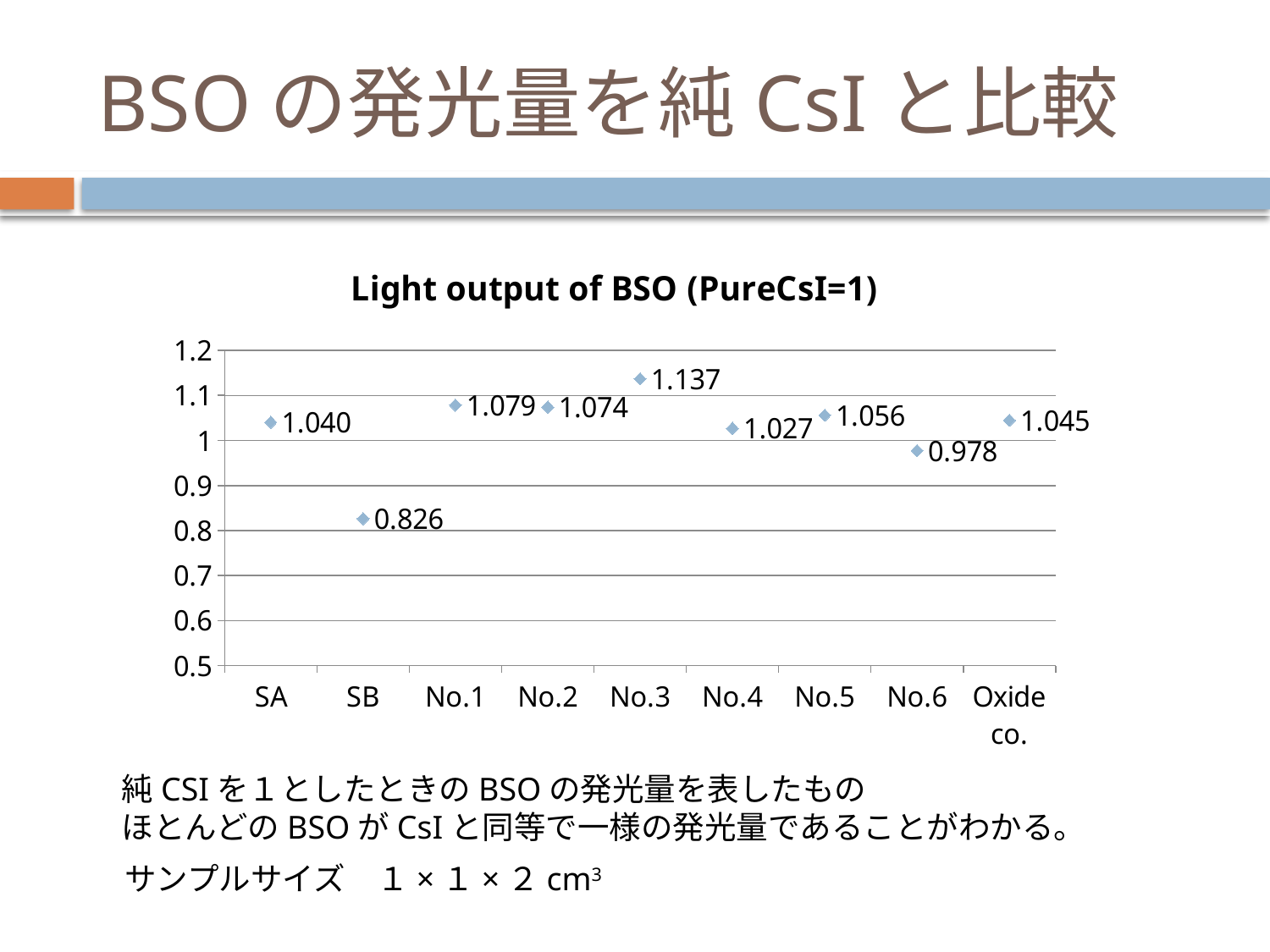
What kind of chart is shown on the slide? scatter chart Is the value for No.6 greater or less than 1? less Which sample has the highest light output? No.3 Which sample has the lowest light output? SB What is the light output value for sample SB? 0.826 Which has a larger light output, SA or No.4? SA How many samples are plotted on the chart? 9 What is the light output value for Oxide co.? 1.045 What is the difference between the light output of No.3 and SB? 0.311 What is the title of the chart? Light output of BSO (PureCsI=1) What is the light output value for sample No.6? 0.978 What is the light output value for sample No.3? 1.137